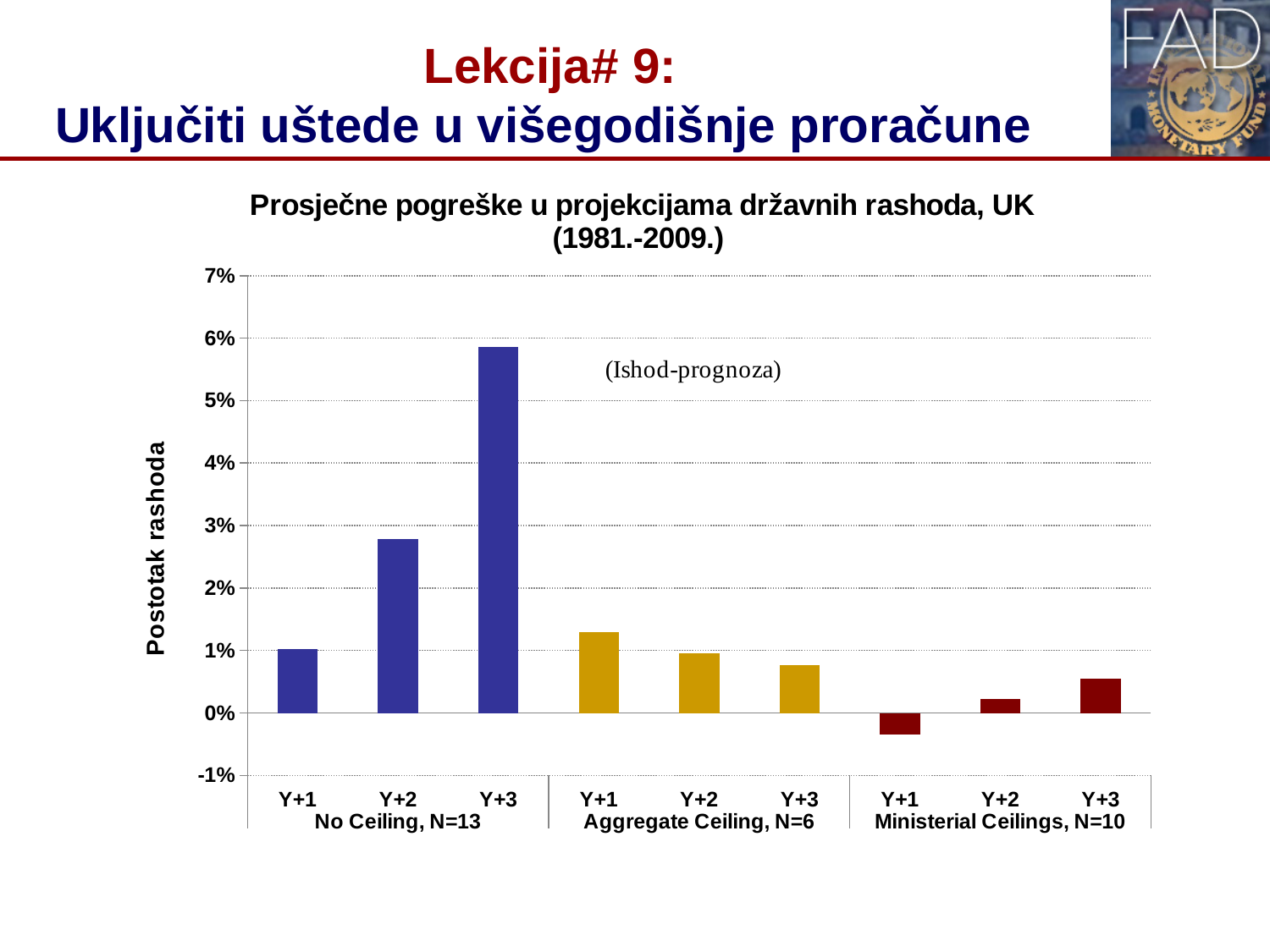
Is the value for Y+3 under No Ceiling, N=13 greater or less than 5%? greater Do the values rise or fall from Y+1 to Y+3 within the Aggregate Ceiling, N=6 group? fall Is the value for Y+2 under No Ceiling, N=13 greater or less than 3%? less How many bars are plotted in the chart? 9 Which bar has the highest value in the chart? Y+3 under No Ceiling, N=13 What is the title of the chart? Prosječne pogreške u projekcijama državnih rashoda, UK (1981.-2009.) What is the label of the vertical axis? Postotak rashoda How many groups of bars (ceiling categories) are shown on the x axis? 3 What kind of chart is shown on the slide? Bar chart Which bar has the lowest value in the chart? Y+1 under Ministerial Ceilings, N=10 Is the value for Y+1 under Ministerial Ceilings, N=10 greater or less than 0%? less Which is larger: Y+2 under No Ceiling, N=13 or Y+1 under Aggregate Ceiling, N=6? Y+2 under No Ceiling, N=13